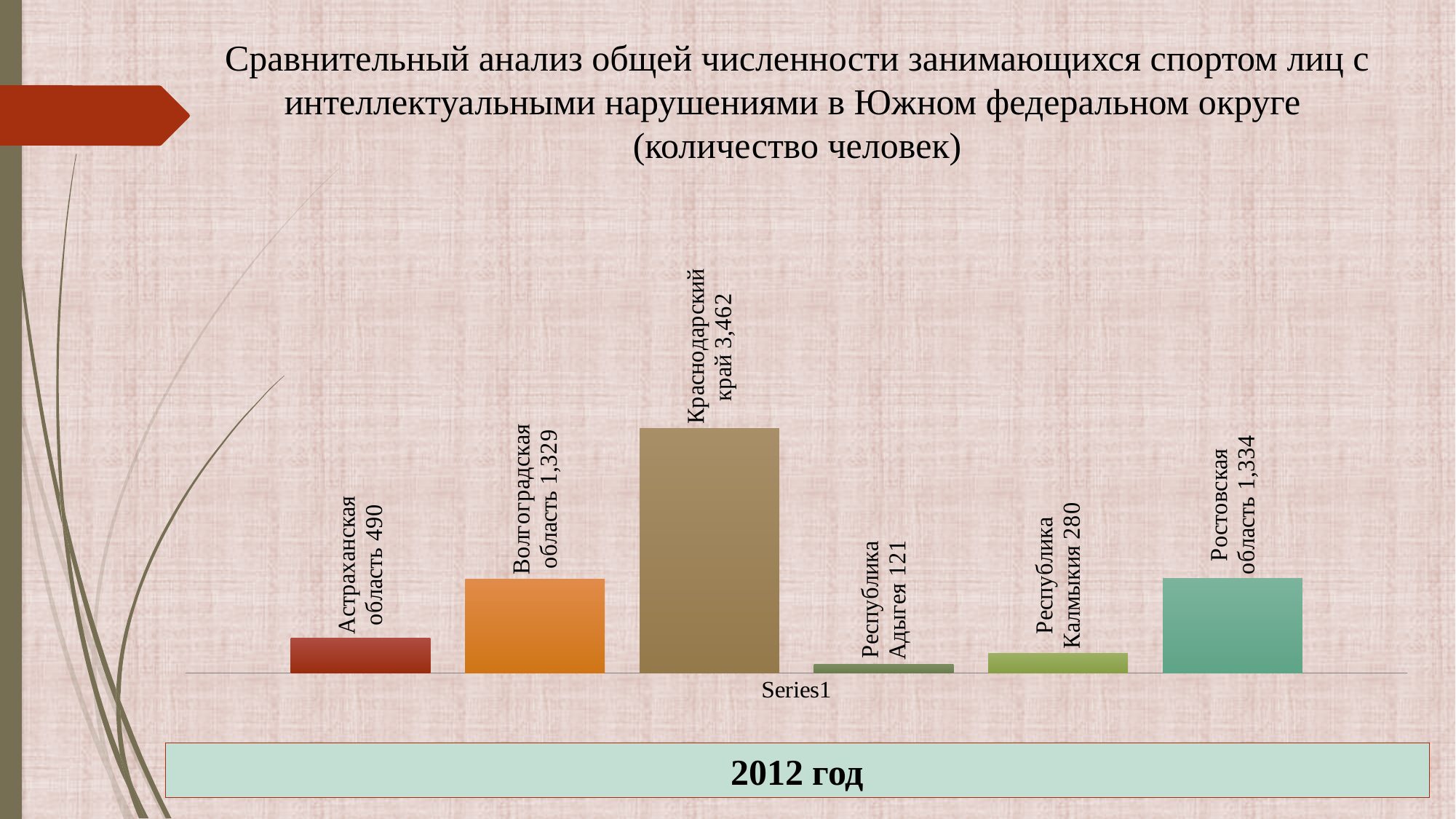
What is the difference between the values for Астраханская область and Республика Калмыкия? 210 Which region has the lowest value? Республика Адыгея What is the value for Ростовская область? 1,334 Which region has the highest value? Краснодарский край Which is larger, the value for Ростовская область or Волгоградская область? Ростовская область What is the value for Астраханская область? 490 What year is shown in the box below the chart? 2012 год What is the value for Республика Калмыкия? 280 How many regions are shown in the chart? 6 What is the difference between the values for Краснодарский край and Волгоградская область? 2,133 What kind of chart is shown on the slide? Bar chart What is the value for Краснодарский край? 3,462